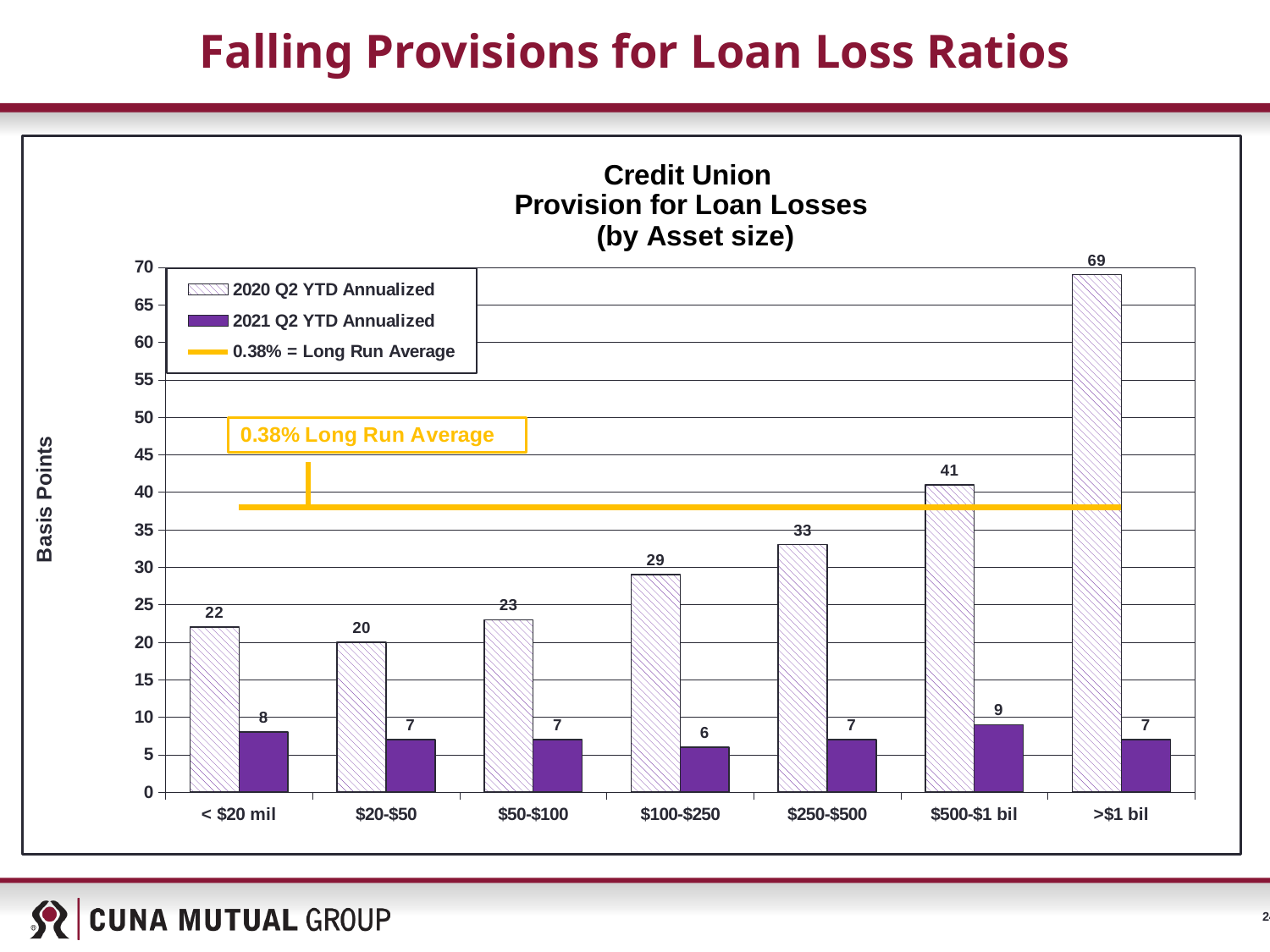
What kind of chart is shown on the slide? Bar chart Is the 2020 Q2 YTD Annualized value for $500-$1 bil greater or less than 40? greater What is the difference between the 2020 Q2 YTD Annualized and 2021 Q2 YTD Annualized values for the $500-$1 bil category? 32 How many entries does the legend list? 3 How many asset size categories are shown on the x axis? 7 Which asset size category has the lowest 2020 Q2 YTD Annualized value? $20-$50 Do the 2020 Q2 YTD Annualized values generally rise or fall from the $20-$50 category to the >$1 bil category? Rise What is the label on the y axis of the chart? Basis Points What is the 2020 Q2 YTD Annualized value for the >$1 bil asset size category? 69 Which is larger, the 2020 Q2 YTD Annualized value for $250-$500 or for $100-$250? $250-$500 Which asset size category has the highest 2020 Q2 YTD Annualized value? >$1 bil What is the 2021 Q2 YTD Annualized value for the $100-$250 asset size category? 6